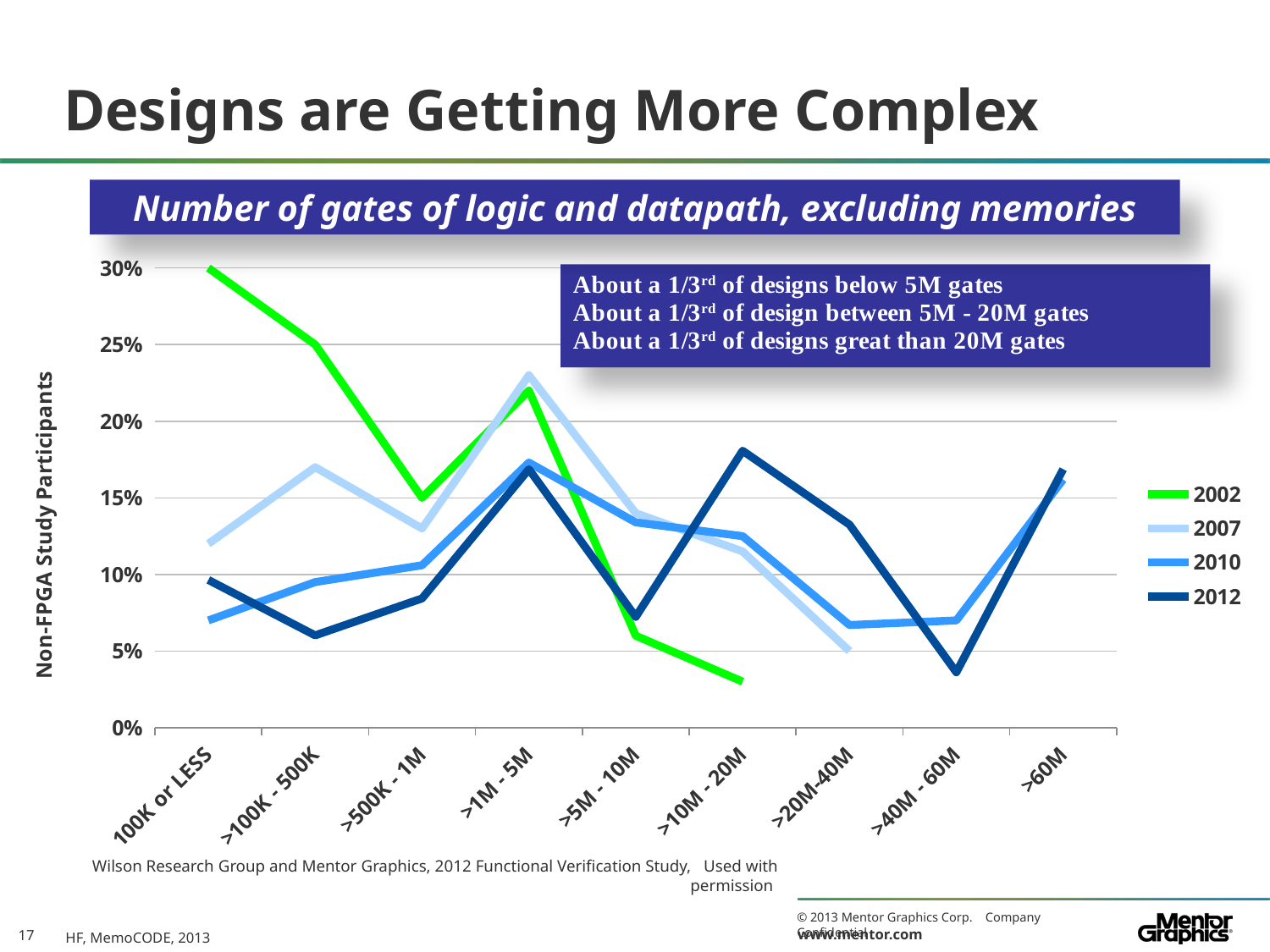
At >10M - 20M, which series has the larger value, 2002 or 2012? 2012 For the 2012 series, which category has the lowest value? >40M - 60M Do the 2002 values overall rise or fall from 100K or LESS to >10M - 20M? fall Is the 2007 value for >1M - 5M greater or less than 20%? greater Is the 2012 value for >40M - 60M greater or less than 5%? less What is the title of the chart? Number of gates of logic and datapath, excluding memories How many categories are shown along the x axis? 9 Is the 2002 value for 100K or LESS greater or less than 25%? greater What kind of chart is shown on the slide? line chart How many series does the legend list? 4 For the 2002 series, which category has the highest value? 100K or LESS What is the label of the y axis? Non-FPGA Study Participants